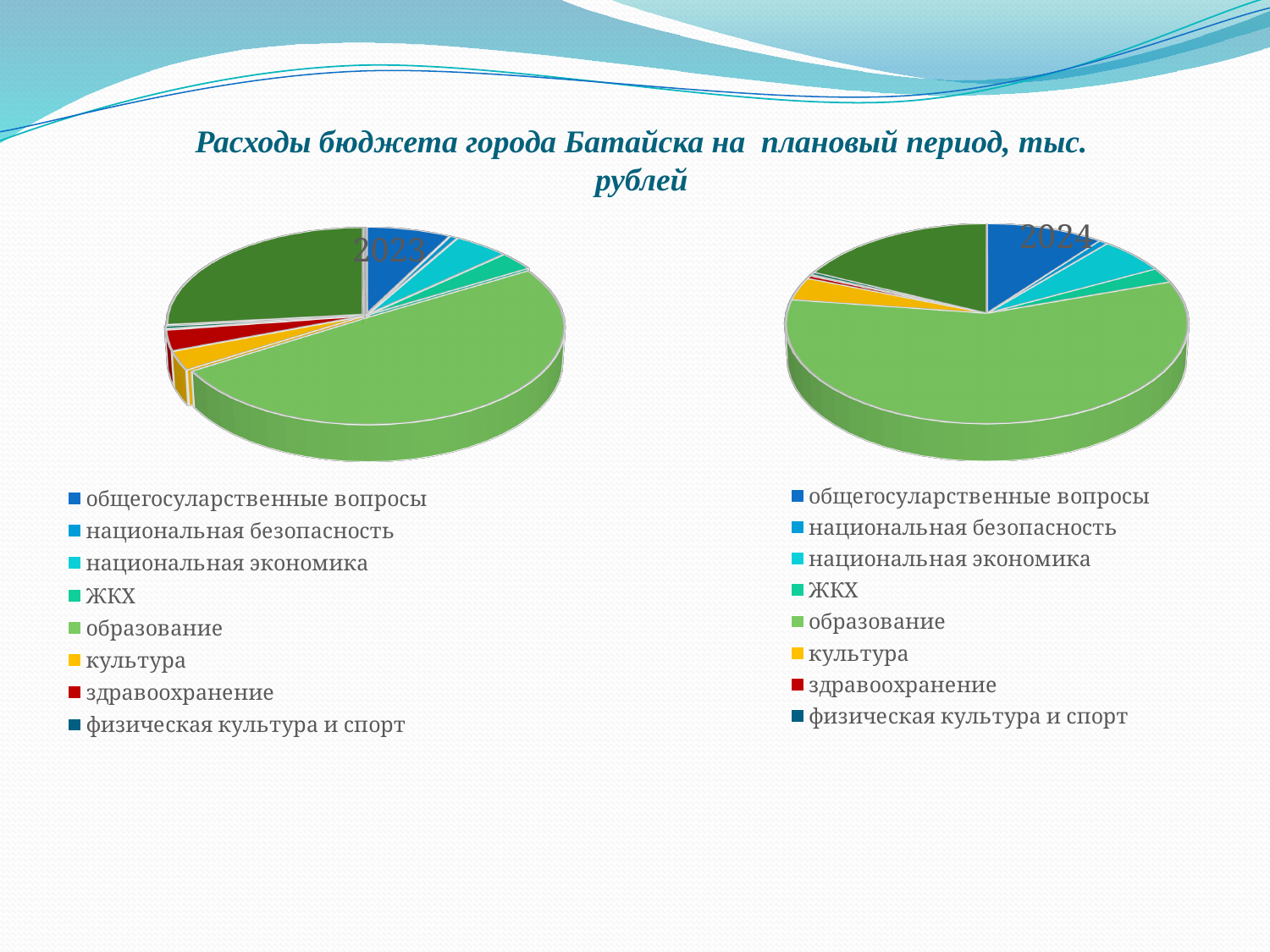
Which category is shown in yellow in the legend of the 2024 chart? культура What is the title of the slide's charts? Расходы бюджета города Батайска на плановый период, тыс. рублей In the 2023 chart, which category has the largest slice? образование What kind of chart is the 2023 chart? pie chart How many categories does the legend of the 2024 chart list? 8 In the 2024 chart, which slice is larger: образование or физическая культура и спорт? образование In the 2023 chart, which slice is larger: образование or общегосударственные вопросы? образование In the 2024 chart, which category has the largest slice? образование How many categories does the legend of the 2023 chart list? 8 What kind of chart is the 2024 chart? pie chart In the 2024 chart, which slice is larger: общегосударственные вопросы or здравоохранение? общегосударственные вопросы